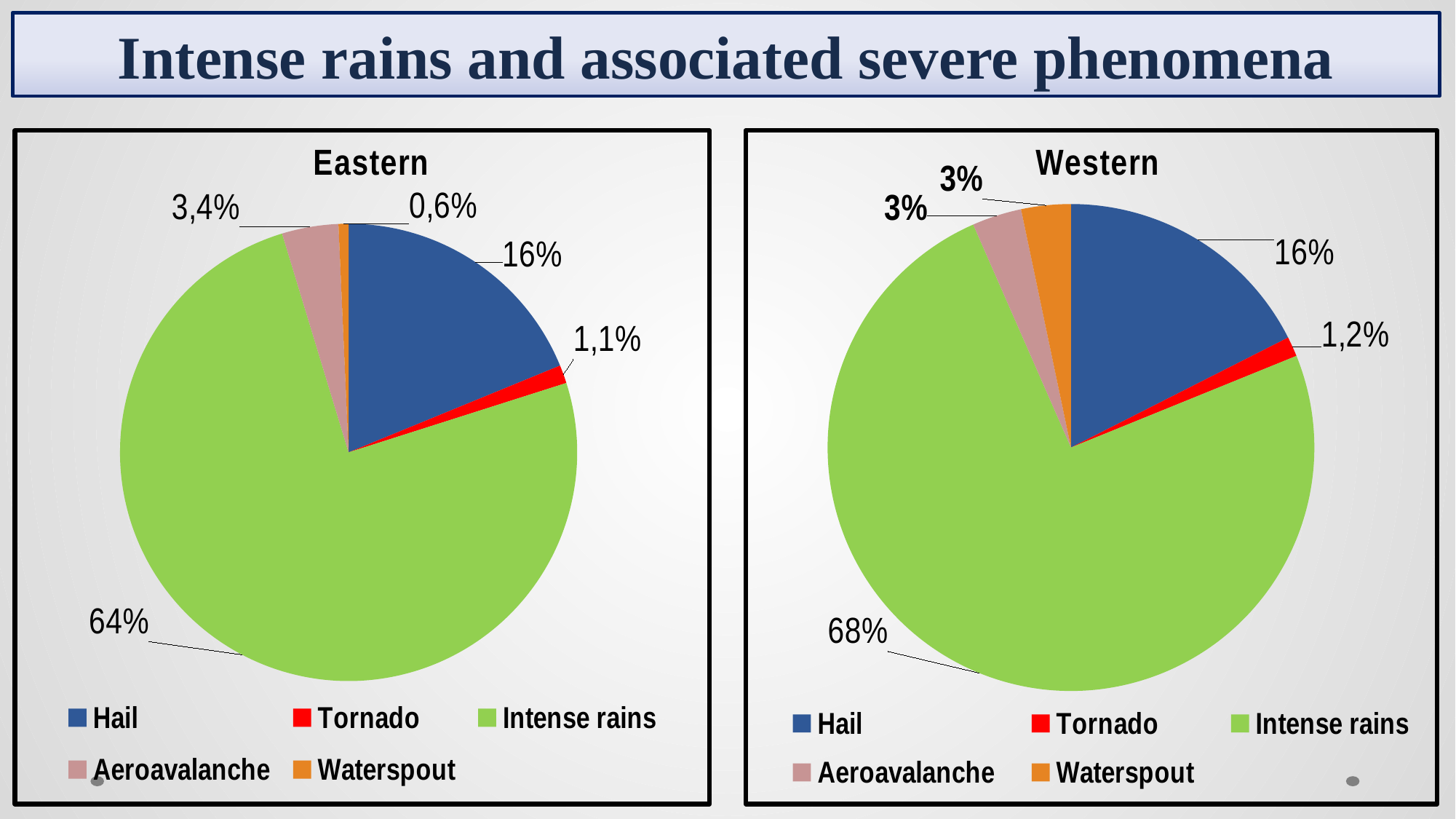
In the Eastern pie chart, what is the value shown for Hail? 16% In the Eastern pie chart, what share is labelled for Intense rains? 64% In the Eastern pie chart, what is the value shown for Waterspout? 0,6% In the Eastern pie chart, which is larger: the Hail slice or the Aeroavalanche slice? Hail In the Eastern pie chart, what is the value shown for Aeroavalanche? 3,4% In the Western pie chart, what share is labelled for Intense rains? 68% What type of chart is used for the Eastern data? Pie chart In the Western pie chart, what is the value shown for Tornado? 1,2% In the Western pie chart, which category has the largest slice? Intense rains How many categories does the legend of the Western pie chart list? 5 What is the difference between the Intense rains share in the Western chart and in the Eastern chart? 4% In the Eastern pie chart, which category has the smallest slice? Waterspout